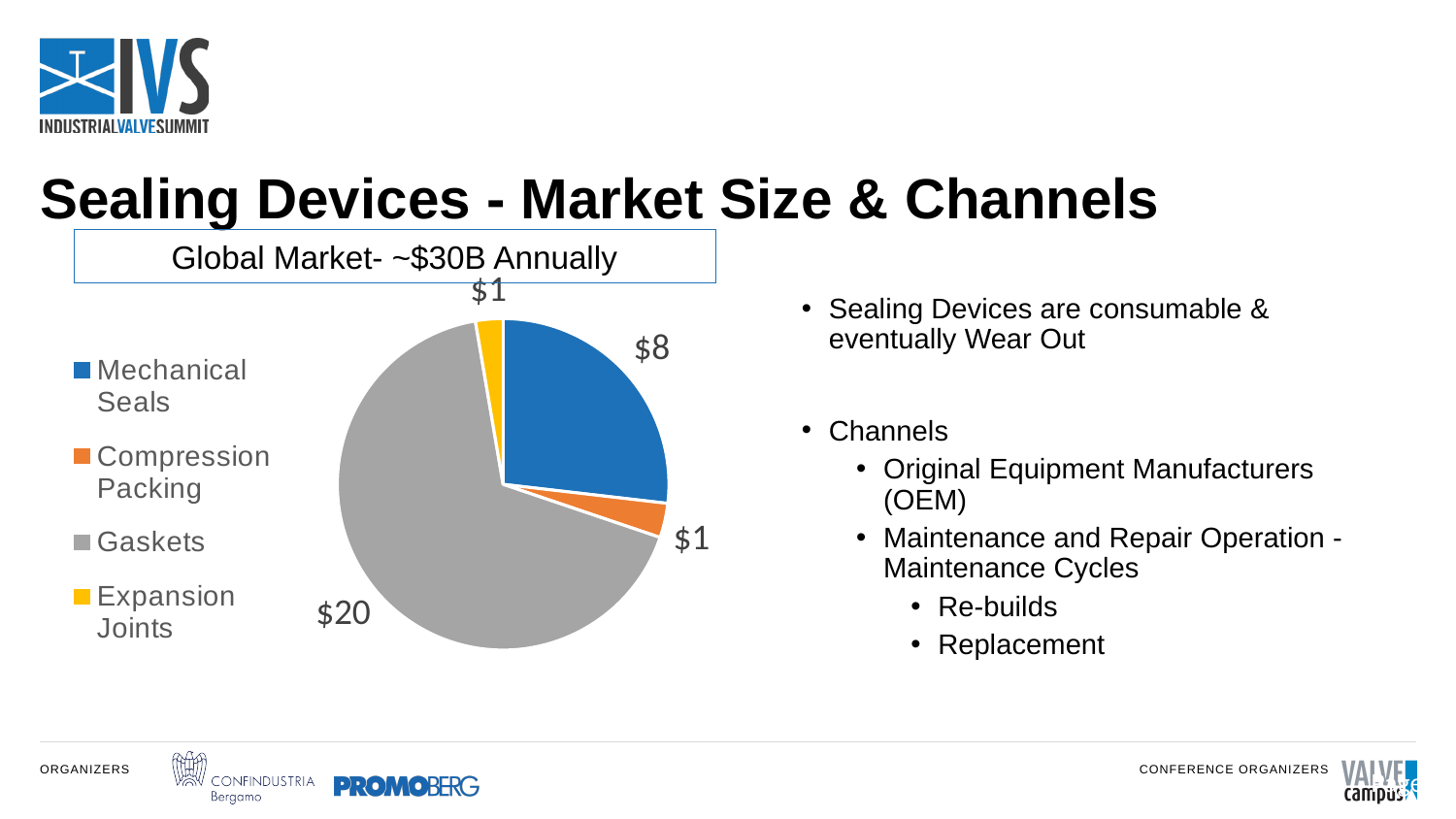
What is the value shown for Compression Packing in the pie chart? $1 What is the difference between the values for Gaskets and Mechanical Seals? $12 Which category has the largest slice of the pie chart? Gaskets What is the title of the pie chart? Global Market- ~$30B Annually What is the value shown for Gaskets in the pie chart? $20 Which is larger, the value for Mechanical Seals or the value for Compression Packing? Mechanical Seals What colour is the Gaskets slice in the pie chart? Gray How many categories does the pie chart show? 4 What type of chart is shown on the slide? Pie chart What is the total of all the slice values in the pie chart? $30 What is the value shown for Expansion Joints in the pie chart? $1 What is the value shown for Mechanical Seals in the pie chart? $8